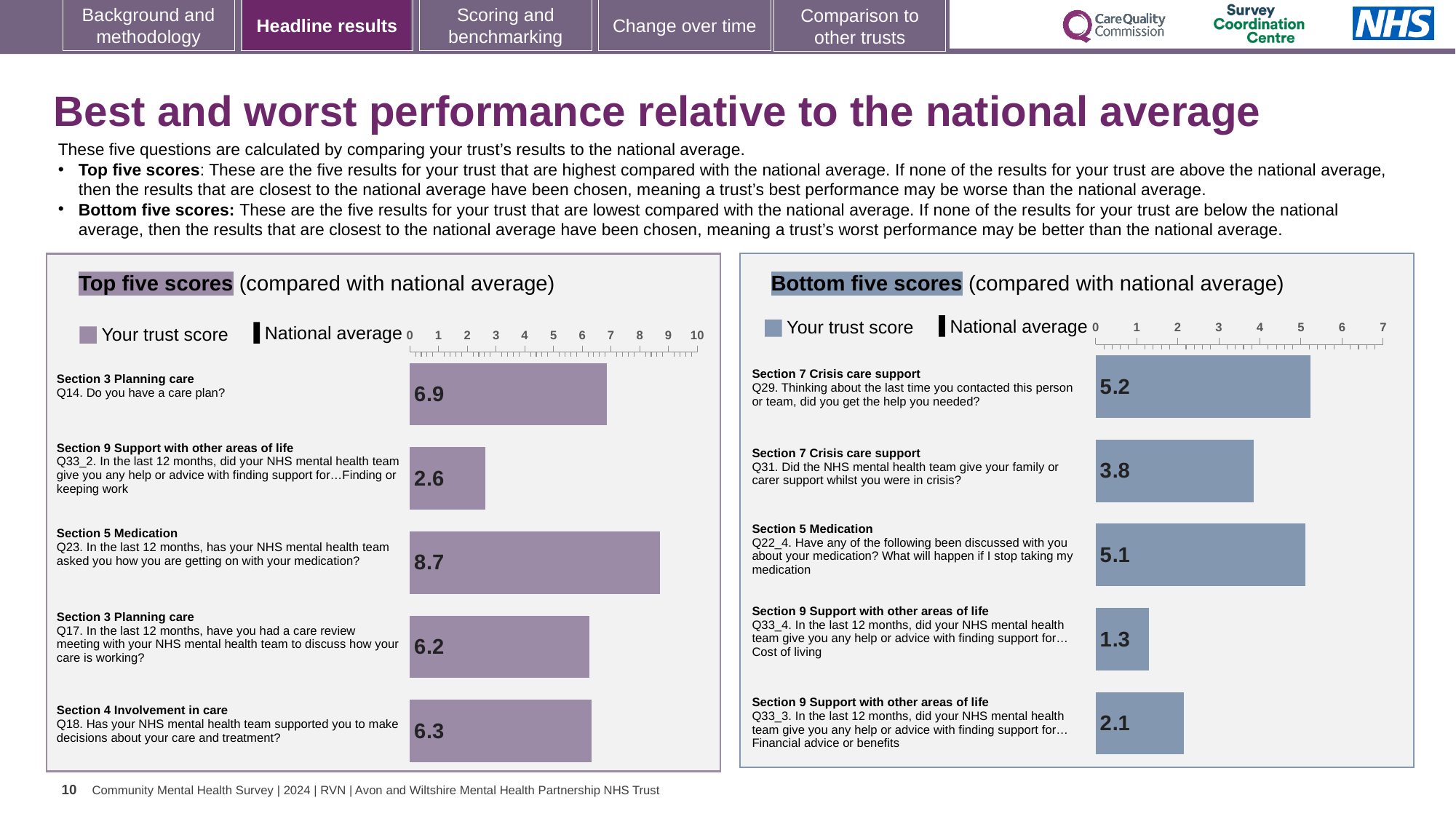
In the 'Bottom five scores' chart, what is the difference between the trust scores for Q29 and Q22_4? 0.1 In the 'Bottom five scores' chart, what is the maximum value shown on the axis? 7 In the 'Bottom five scores' chart, which question has the lowest trust score? Q33_4 (Section 9 Support with other areas of life) In the 'Top five scores' chart, which question has the lowest trust score? Q33_2 (Section 9 Support with other areas of life) In the 'Top five scores' chart, which question has the highest trust score? Q23 (Section 5 Medication) In the 'Top five scores' chart, how many questions are plotted? 5 In the 'Bottom five scores' chart, what is the trust score for Q31 (Did the NHS mental health team give your family or carer support whilst you were in crisis?)? 3.8 In the 'Bottom five scores' chart, which question has the highest trust score? Q29 (Section 7 Crisis care support) In the 'Top five scores' chart, what is the difference between the trust scores for Q23 and Q17? 2.5 In the 'Top five scores' chart, what is the trust score for Q14 (Do you have a care plan?)? 6.9 What type of chart is used in the 'Top five scores' panel? Bar chart In the 'Bottom five scores' chart, which has the larger trust score: Q33_4 or Q33_3? Q33_3